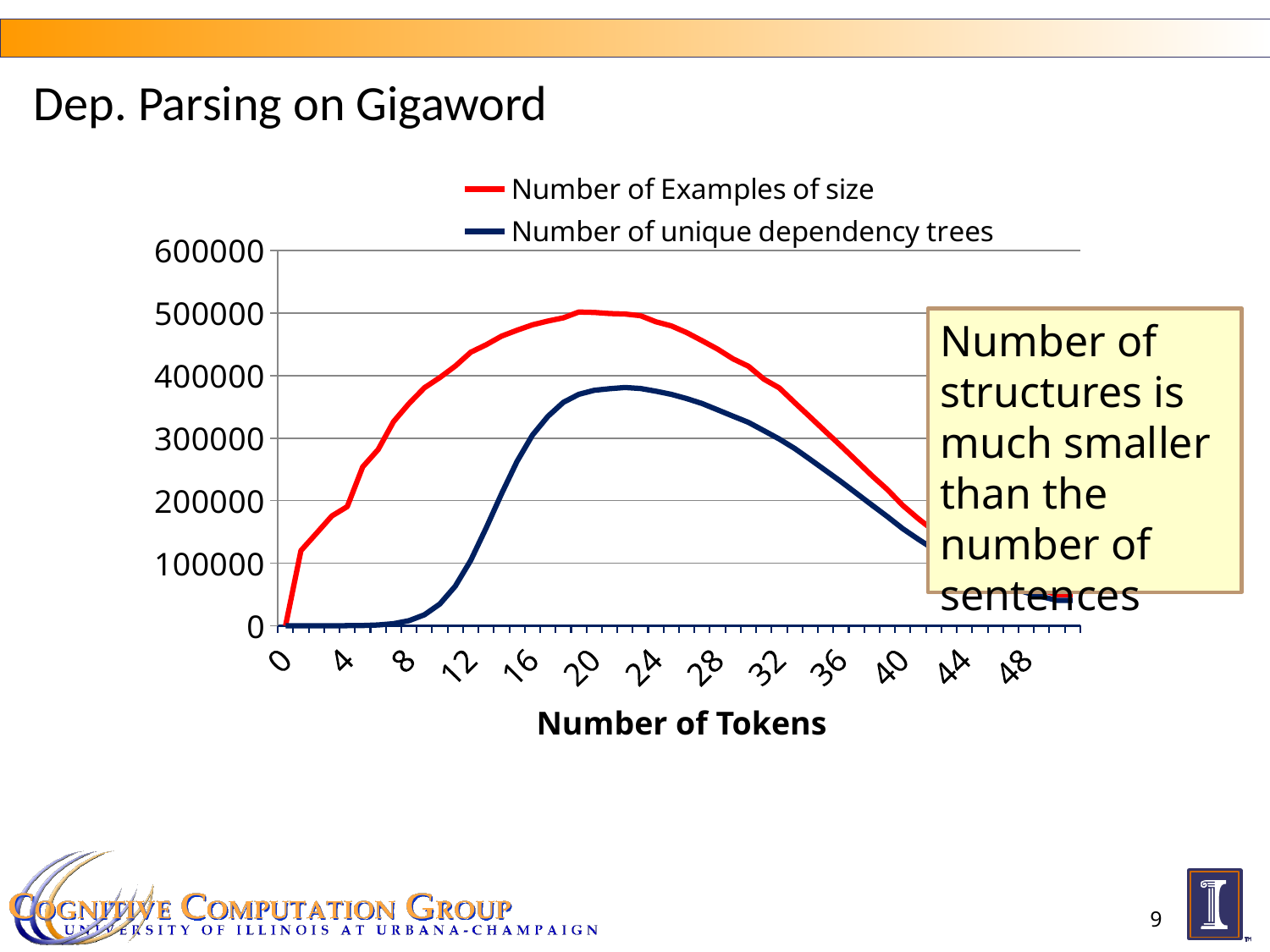
Does the Number of Examples of size series rise or fall between 24 and 48 tokens? fall Is the value of Number of unique dependency trees at 8 tokens greater or less than 100000? less Is the value of Number of Examples of size at 8 tokens greater or less than 300000? greater Does the Number of unique dependency trees series rise or fall between 8 and 20 tokens? rise At 20 tokens, which series has the larger value: Number of Examples of size or Number of unique dependency trees? Number of Examples of size What is the title of the x axis? Number of Tokens What kind of chart is shown on the slide? line chart Is the value of Number of Examples of size at 12 tokens greater or less than 400000? greater How many series does the legend list? 2 Which series is drawn in red? Number of Examples of size